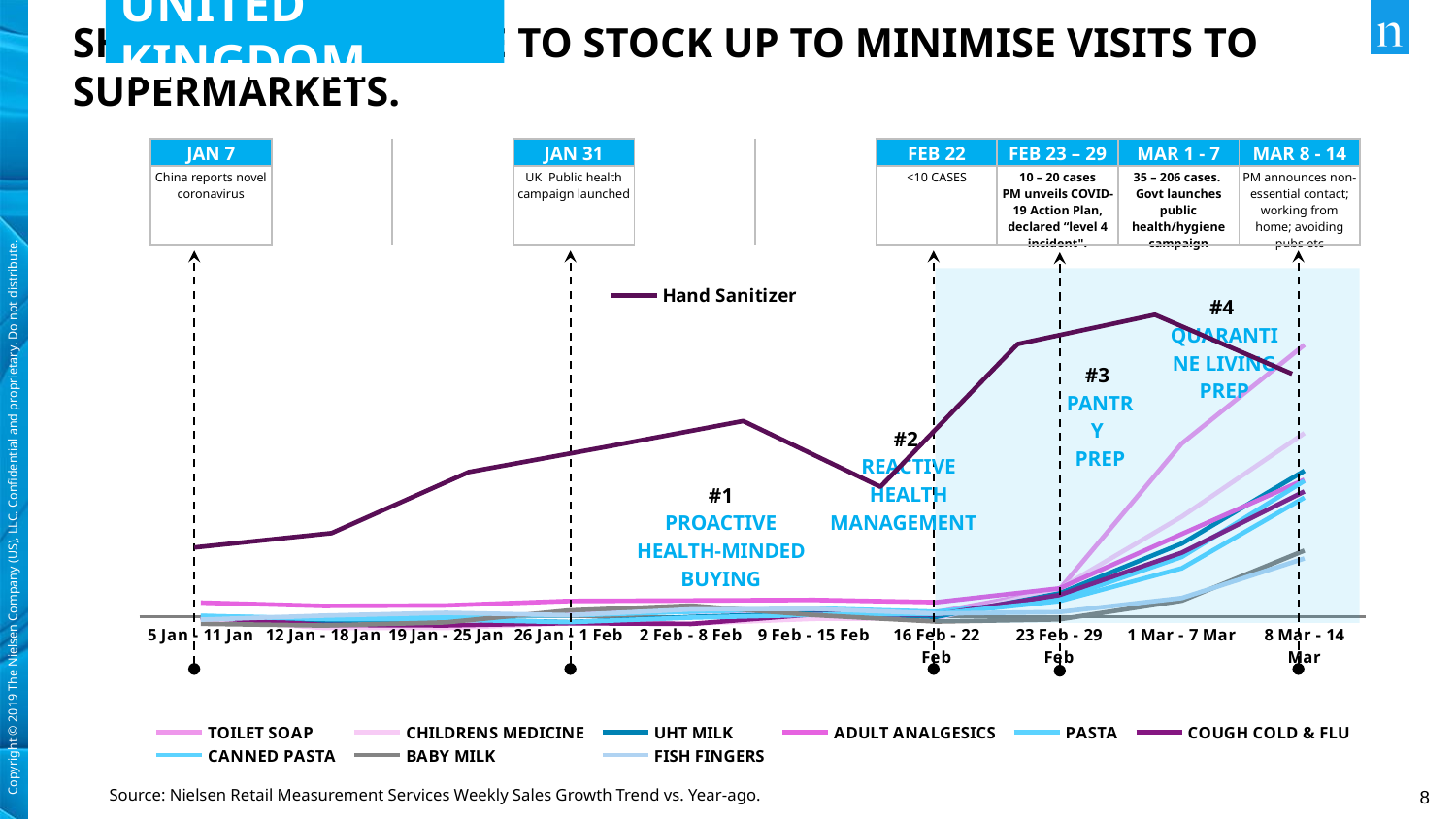
What kind of chart is shown on the slide? Line chart Which series is highest in the 23 Feb - 29 Feb period? Hand Sanitizer How many series does the legend at the bottom of the chart list? 9 What is the name of phase #1 annotated on the chart? Proactive Health-Minded Buying Is the Hand Sanitizer value higher in 1 Mar - 7 Mar or in 8 Mar - 14 Mar? 1 Mar - 7 Mar Which series is highest in the 1 Mar - 7 Mar period? Hand Sanitizer How many weekly periods are shown along the x axis of the chart? 10 What is the name of phase #3 annotated on the chart? Pantry Prep Does the Hand Sanitizer line rise or fall from 5 Jan - 11 Jan to 23 Feb - 29 Feb? Rises Which series is lowest in the 8 Mar - 14 Mar period? Fish Fingers